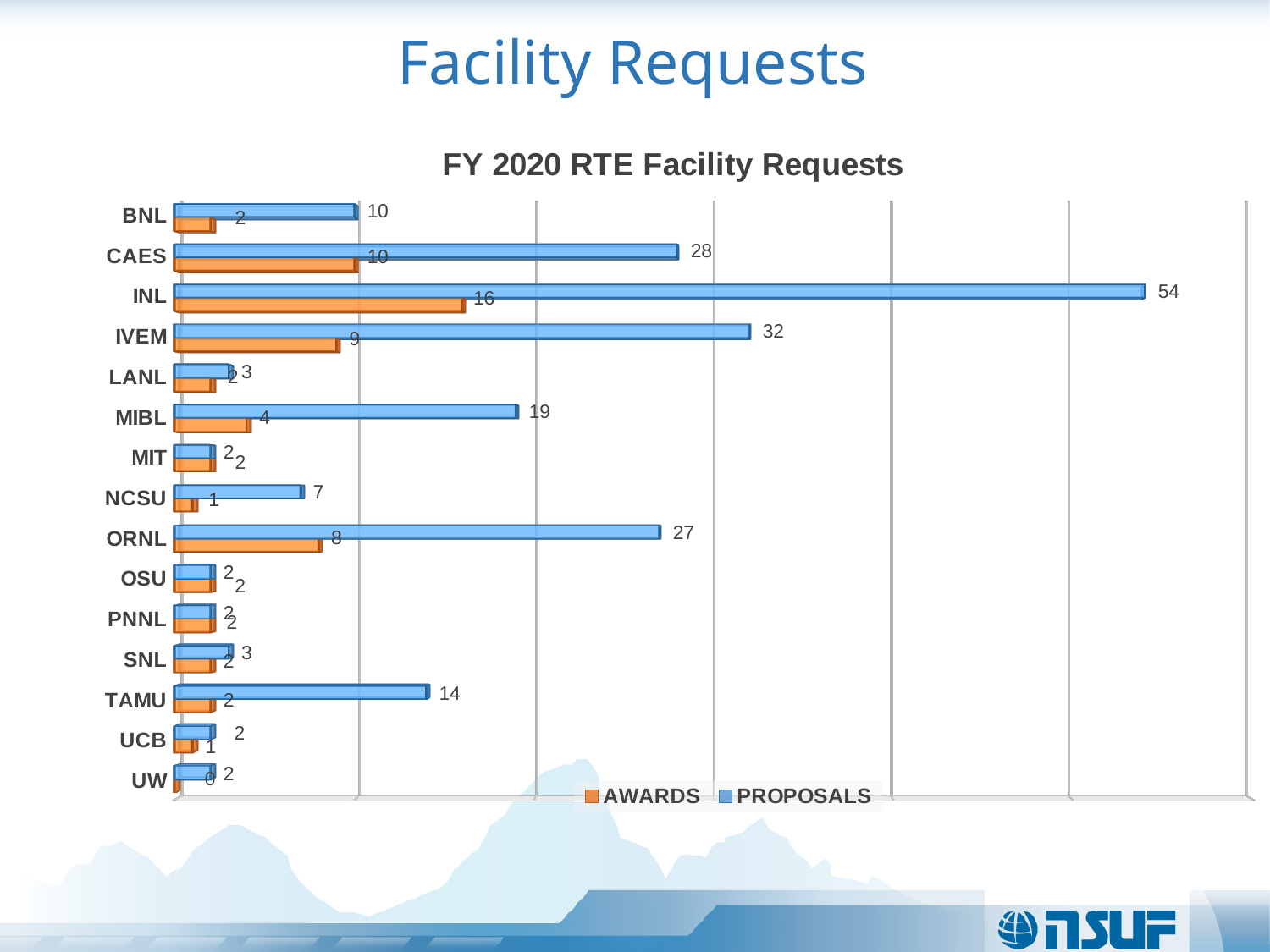
Which facility has the highest number of PROPOSALS? INL What type of chart is shown on the slide? bar chart What is the number of AWARDS for CAES? 10 What is the number of PROPOSALS for ORNL? 27 What is the difference between PROPOSALS and AWARDS for IVEM? 23 What is the title of the chart? FY 2020 RTE Facility Requests What is the number of PROPOSALS for INL? 54 Which facility has the lowest number of AWARDS? UW How many facilities (categories) are shown on the chart? 15 How many series does the legend list? 2 What is the difference between the PROPOSALS values for INL and IVEM? 22 Which is larger, the PROPOSALS value for CAES or the PROPOSALS value for ORNL? CAES